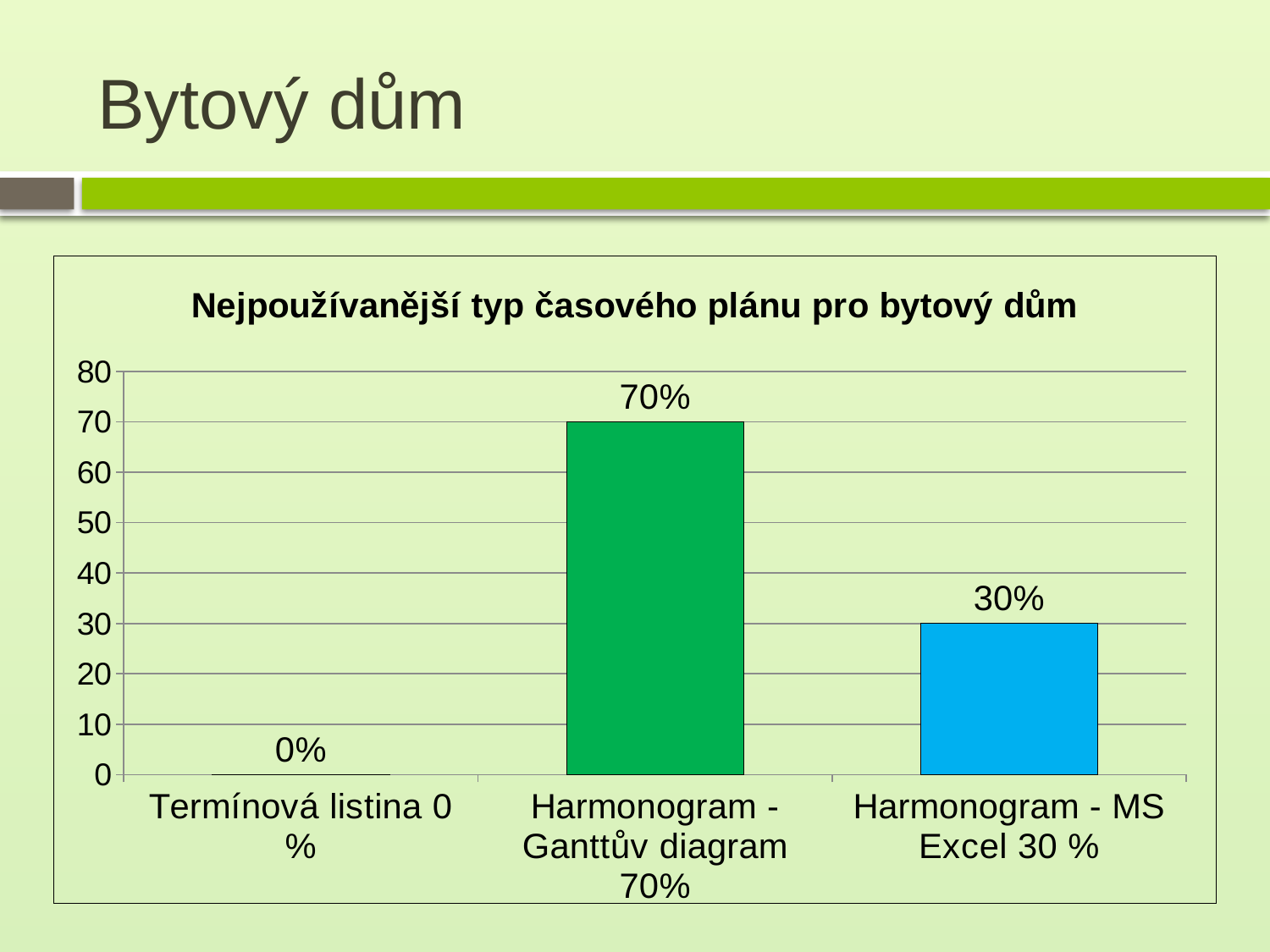
Which is larger, the value for Harmonogram - MS Excel or the value for Termínová listina? Harmonogram - MS Excel Which category has the lowest value? Termínová listina What is the title of the chart? Nejpoužívanější typ časového plánu pro bytový dům What is the value for Termínová listina? 0% What is the value for Harmonogram - MS Excel? 30% Is the value for Harmonogram - Ganttův diagram greater or less than 60? greater How many categories are shown on the chart? 3 Is the value for Harmonogram - MS Excel greater or less than 40? less What is the value for Harmonogram - Ganttův diagram? 70% What kind of chart is shown on the slide? bar chart What is the difference between the values for Harmonogram - Ganttův diagram and Harmonogram - MS Excel? 40% Which category has the highest value? Harmonogram - Ganttův diagram